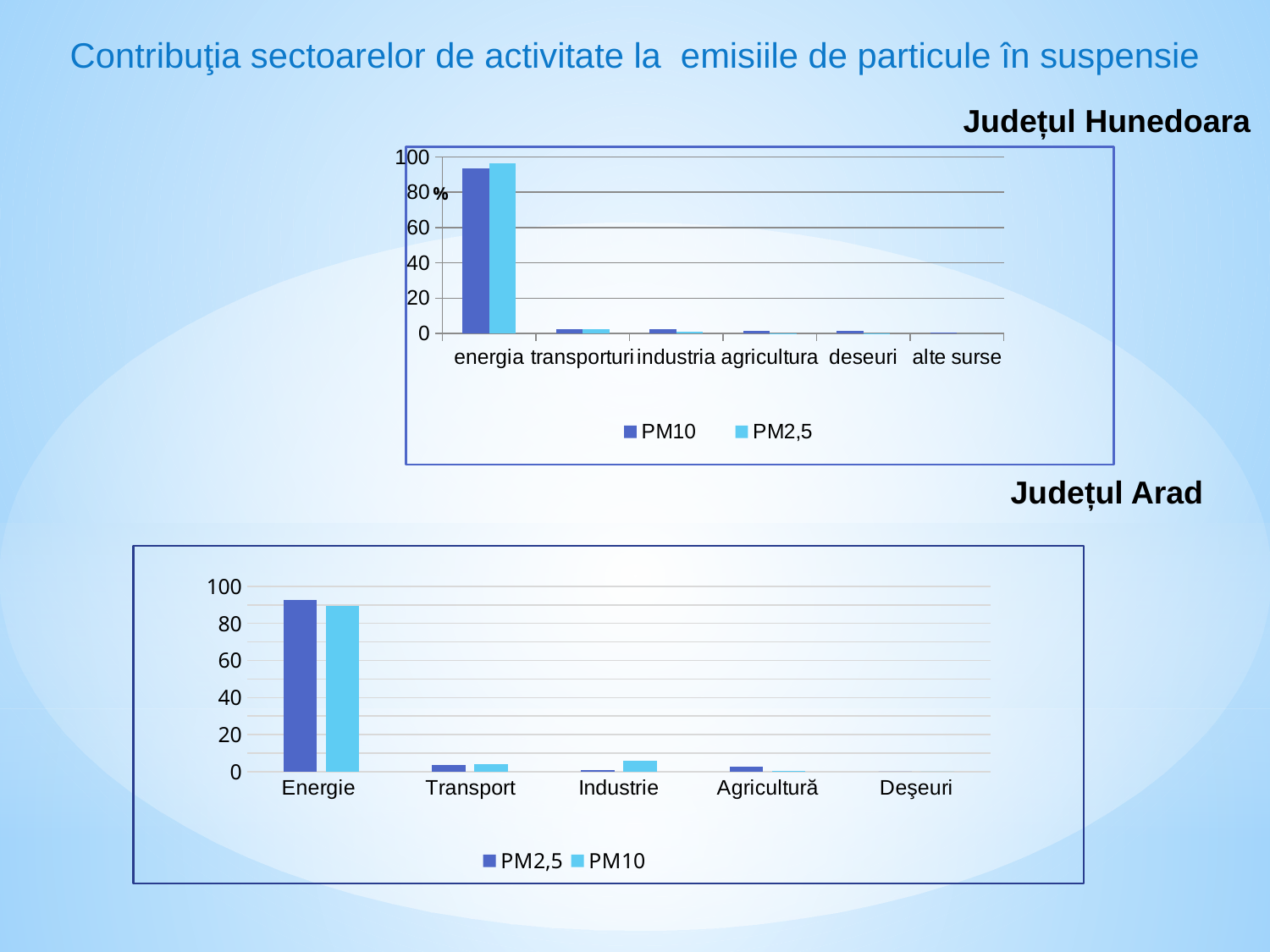
What are the legend entries of the Județul Hunedoara chart? PM10 and PM2,5 In the Județul Hunedoara chart, is the PM10 value for energia greater or less than 80? greater In the Județul Arad chart, is the PM10 value for Transport greater or less than 20? less In the Județul Arad chart, which category has the highest values? Energie How many series does the legend of the Județul Arad chart list? 2 In the Județul Arad chart, which is larger for Industrie, PM2,5 or PM10? PM10 How many categories are shown on the x axis of the Județul Hunedoara chart? 6 In the Județul Hunedoara chart, which category has the highest values? energia In the Județul Hunedoara chart, is the PM2,5 value for transporturi greater or less than 20? less How many categories are shown on the x axis of the Județul Arad chart? 5 What kind of chart is the Județul Hunedoara chart? bar chart